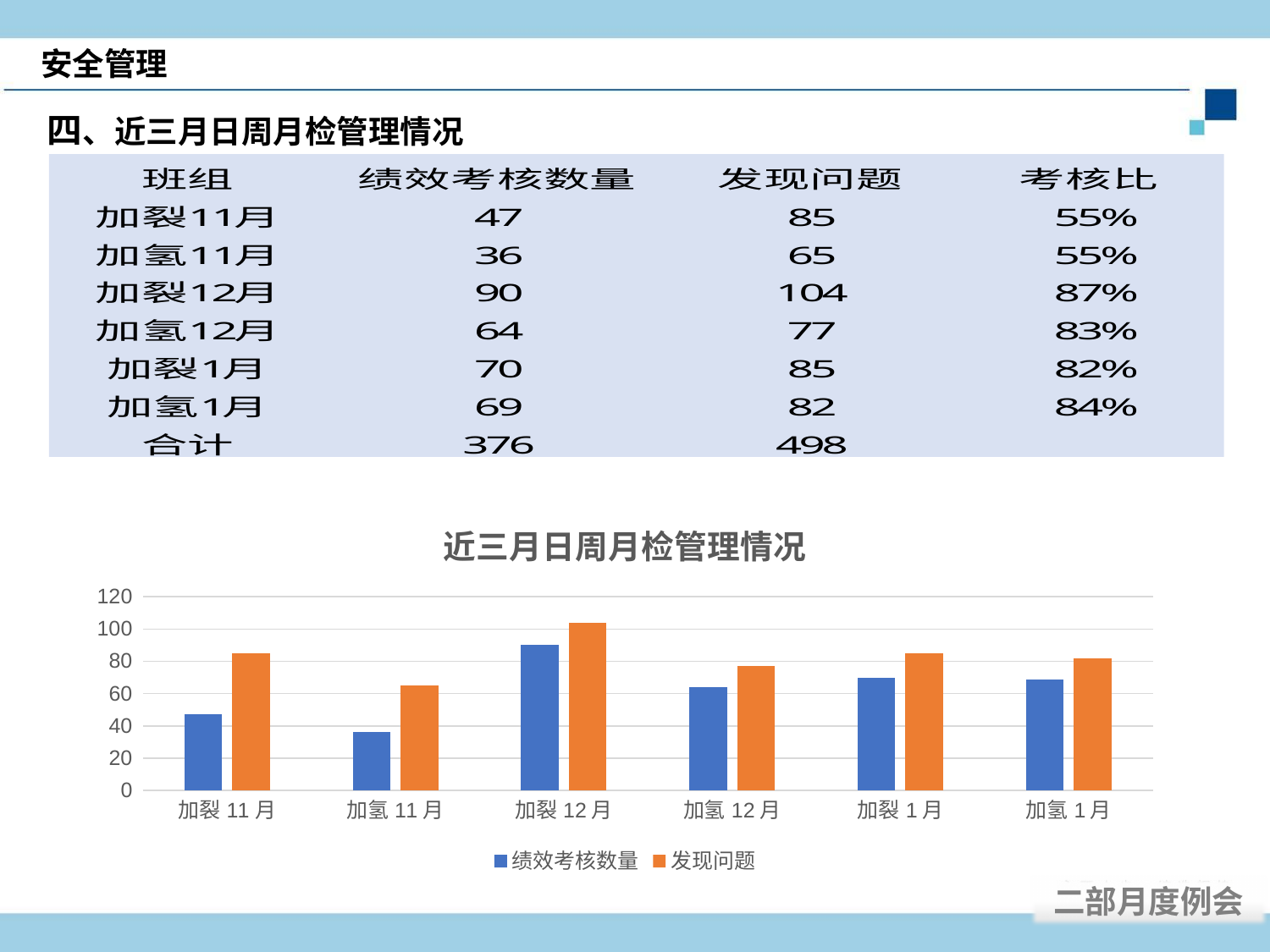
What is the 发现问题 value for 加氢1月? 82 How many series does the chart legend list? 2 How many categories are shown on the x axis of the chart? 6 Is the 发现问题 value for 加裂12月 greater or less than 100? greater What is the title of the chart? 近三月日周月检管理情况 What is the 绩效考核数量 value for 加裂12月? 90 Is the 绩效考核数量 value for 加氢11月 greater or less than 40? less Which is larger for 加裂11月: 绩效考核数量 or 发现问题? 发现问题 What is the difference between the 发现问题 and 绩效考核数量 values for 加裂11月? 38 Which category has the lowest 绩效考核数量 value in the chart? 加氢11月 Which category has the highest 发现问题 value in the chart? 加裂12月 What kind of chart is shown on the slide? bar chart